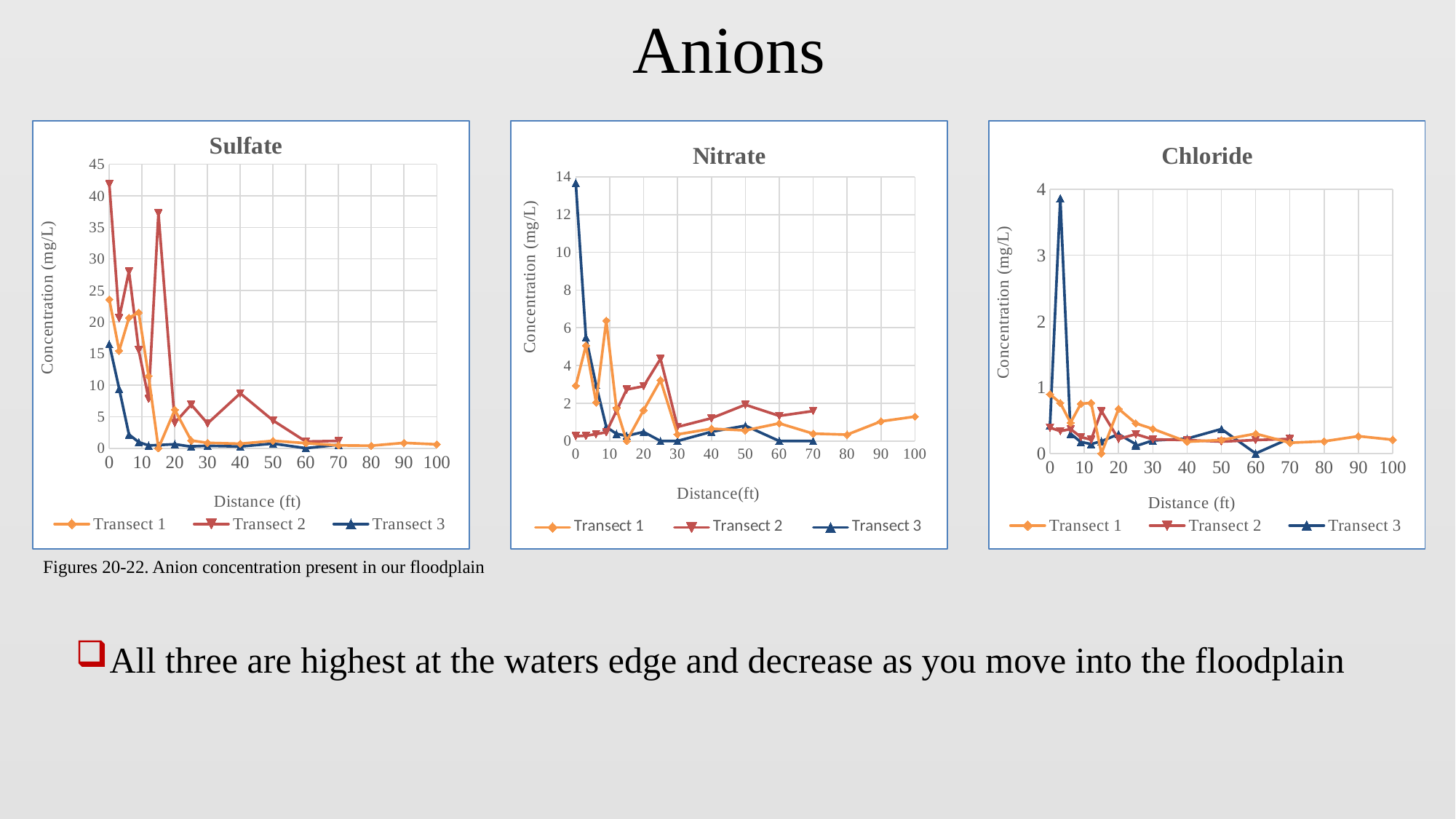
What is the y-axis label of the Chloride chart? Concentration (mg/L) In the Sulfate chart, is the value for Transect 3 at 0 ft greater or less than 20? less In the Sulfate chart, at 0 ft, which is larger: Transect 1 or Transect 2? Transect 2 In the Chloride chart, which transect reaches the highest concentration? Transect 3 In the Nitrate chart, is the value for Transect 3 at 0 ft greater or less than 12? greater In the Sulfate chart, is the value for Transect 2 at 0 ft greater or less than 35? greater In the Nitrate chart, which transect reaches the highest concentration? Transect 3 What kind of chart is the Sulfate chart? line chart In the Sulfate chart, which transect reaches the highest concentration? Transect 2 How many series does the legend of the Nitrate chart list? 3 In the Sulfate chart, does the Transect 3 line generally rise or fall as distance increases? fall